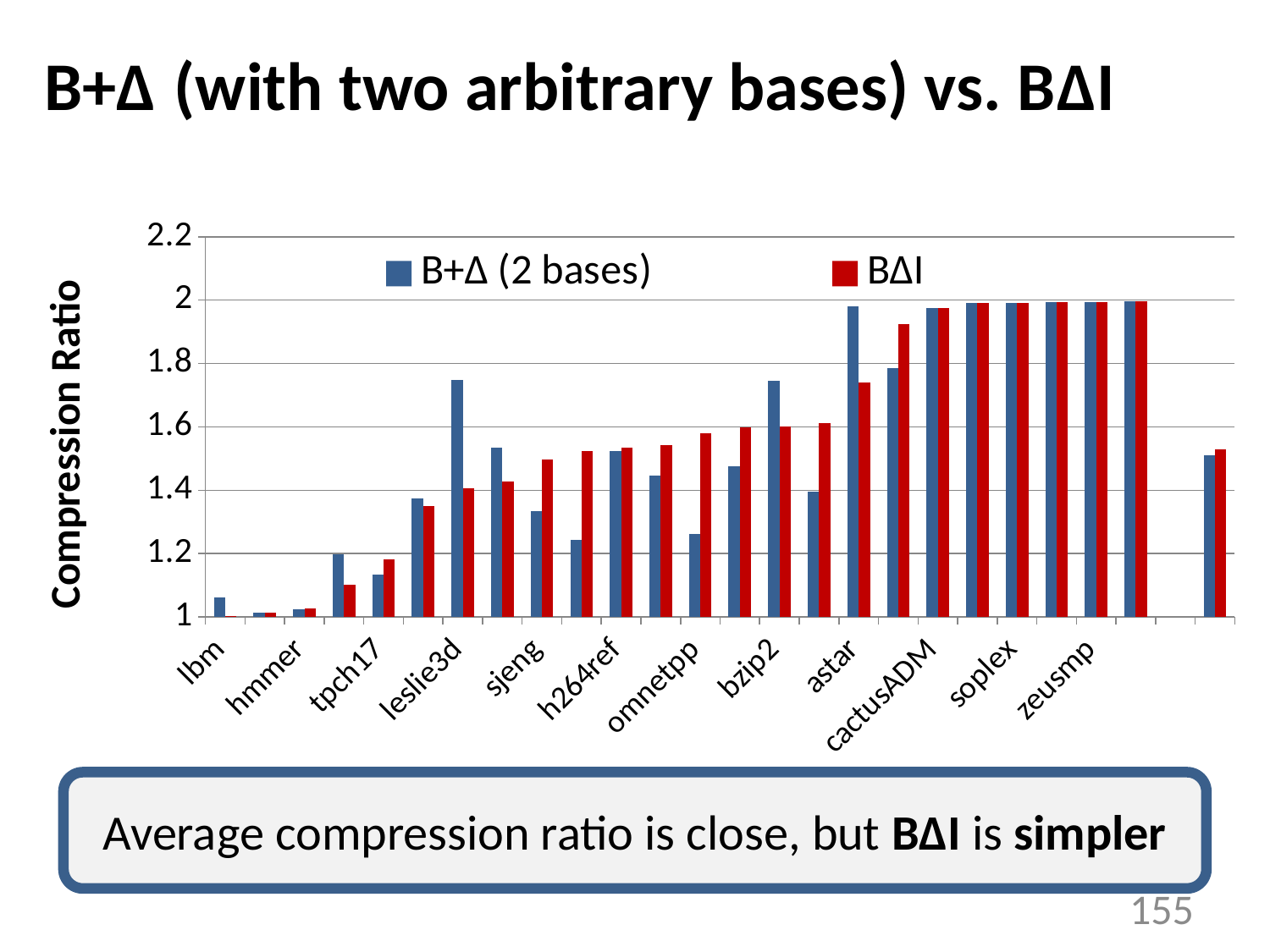
Is the BΔI value for soplex greater or less than 1.8? greater What is the label of the vertical axis? Compression Ratio Is the B+Δ (2 bases) value for sjeng greater or less than 1.4? less For leslie3d, which series has the larger compression ratio, B+Δ (2 bases) or BΔI? B+Δ (2 bases) What are the two series named in the legend? B+Δ (2 bases) and BΔI Do the BΔI compression ratios generally rise or fall from lbm to zeusmp along the x axis? rise Is the B+Δ (2 bases) value for leslie3d greater or less than 1.4? greater What kind of chart is shown on the slide? bar chart How many series does the legend list? 2 For sjeng, which series has the larger compression ratio, B+Δ (2 bases) or BΔI? BΔI